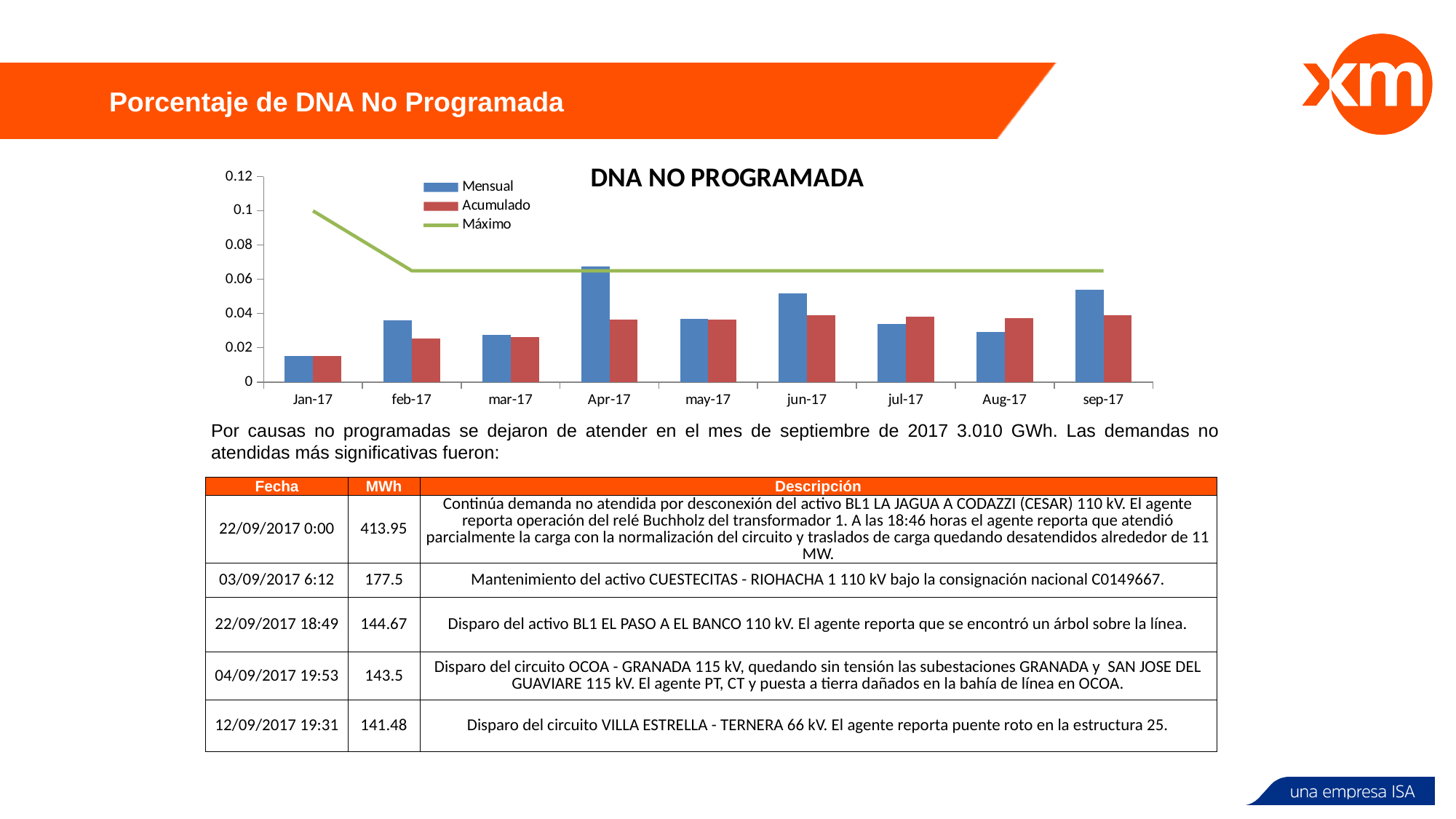
Is the Mensual value for Apr-17 greater or less than 0.06? greater In Apr-17, which is larger, the Mensual value or the Acumulado value? Mensual In which month is the Mensual value highest? Apr-17 Is the Mensual value for Jan-17 greater or less than 0.02? less How many months are shown on the x axis of the DNA NO PROGRAMADA chart? 9 In which month is the Mensual value lowest? Jan-17 How many series does the legend of the DNA NO PROGRAMADA chart list? 3 What are the three entries in the legend of the chart? Mensual, Acumulado, Máximo Is the Máximo value for Jan-17 greater or less than 0.08? greater What kind of chart is the DNA NO PROGRAMADA chart? bar chart (with a line series) Does the Máximo line rise or fall from Jan-17 to feb-17? fall Which month has the larger Mensual value, Apr-17 or jun-17? Apr-17